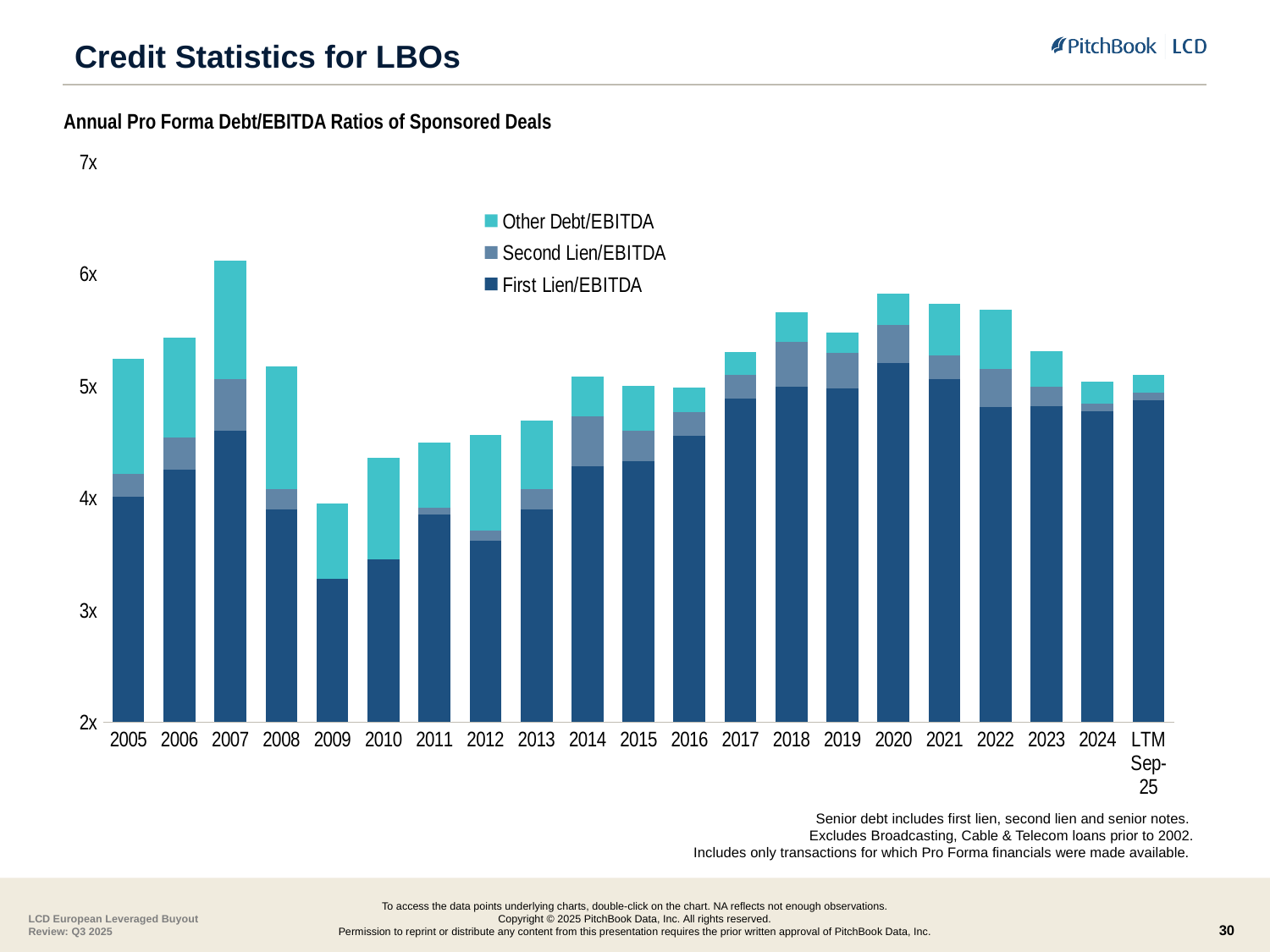
How many series does the legend list? 3 What kind of chart is shown on the slide? Stacked bar chart Which year has the highest total Debt/EBITDA ratio? 2007 Which series is shown in the darkest blue at the bottom of each bar? First Lien/EBITDA Is the total Debt/EBITDA ratio for 2010 greater or less than 5x? less Which year has the lowest total Debt/EBITDA ratio? 2009 Is the total Debt/EBITDA ratio for 2007 greater or less than 6x? greater Which year has the lowest First Lien/EBITDA value? 2009 How many periods are shown along the x axis? 21 Which year has the larger total Debt/EBITDA ratio, 2020 or 2010? 2020 Is the First Lien/EBITDA value for 2009 greater or less than 4x? less Do the total Debt/EBITDA ratios generally rise or fall from 2009 to 2020? rise